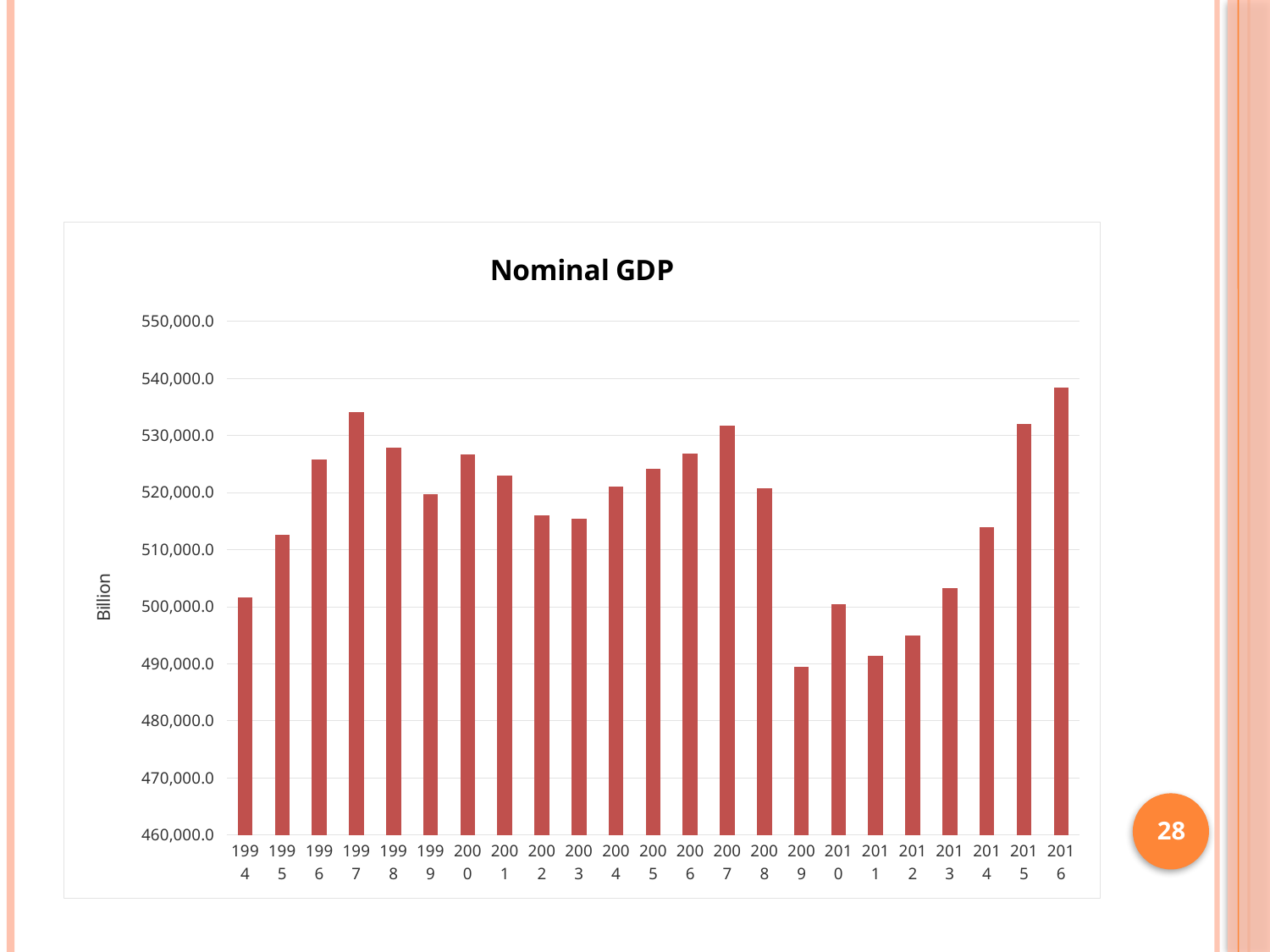
Which year has the lowest nominal GDP in the chart? 2009 Is the value for 2012 greater or less than 500,000.0? less Is the value for 1997 greater or less than 530,000.0? greater What is the title of the chart? Nominal GDP What is the label on the vertical axis of the chart? Billion How many years (bars) are plotted in the chart? 23 What kind of chart is shown on the slide? Bar chart Which year has the larger nominal GDP, 1997 or 1998? 1997 Is the value for 2014 greater or less than 510,000.0? greater Which year has the highest nominal GDP in the chart? 2016 Do the values rise or fall from 2011 to 2016? Rise